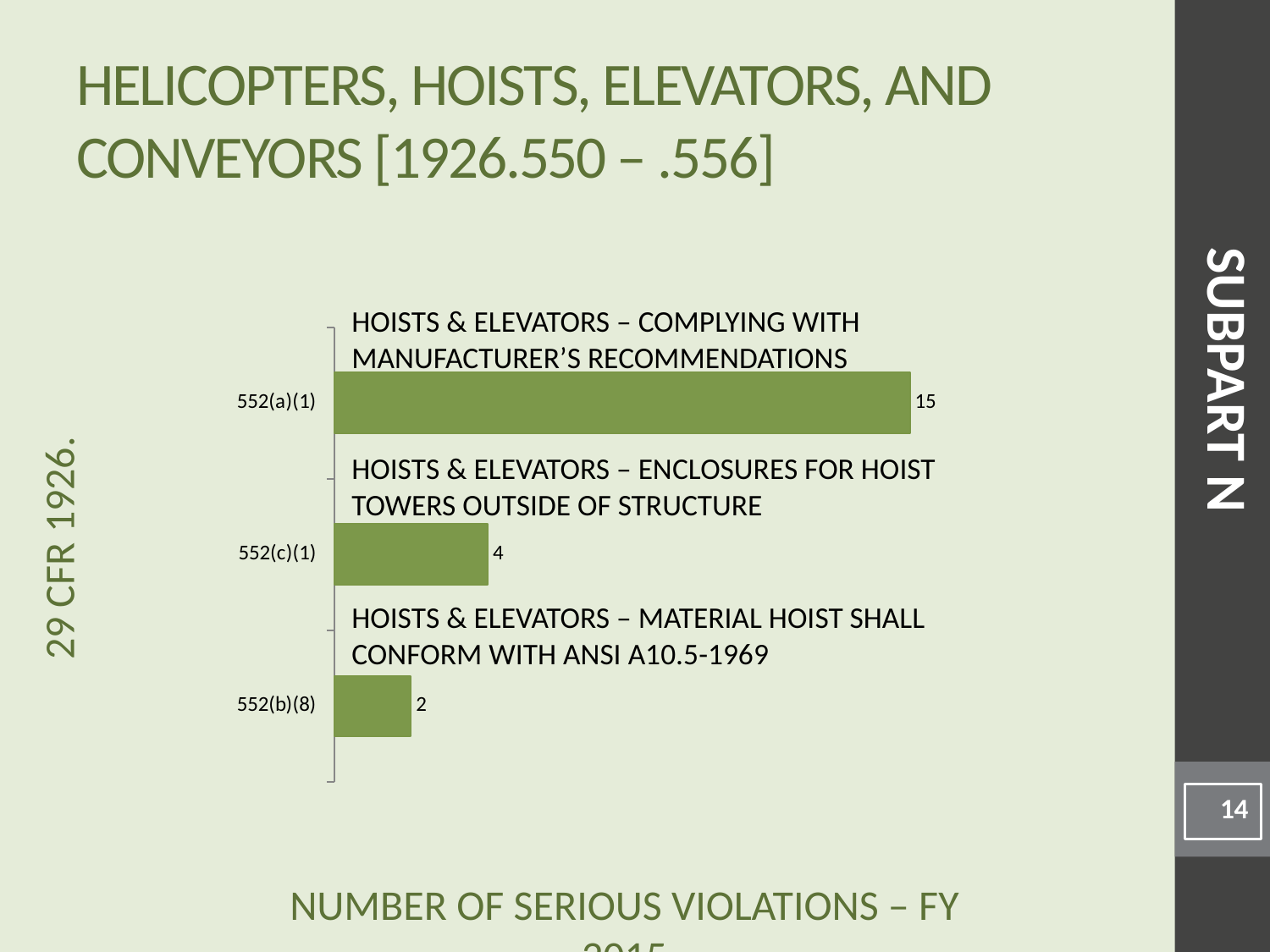
What is the number of serious violations for 552(b)(8)? 2 What is the difference between the violations for 552(a)(1) and 552(c)(1)? 11 What kind of chart is shown on the slide? Bar chart What is the number of serious violations for 552(c)(1)? 4 Which standard has the highest number of serious violations? 552(a)(1) How many standards (categories) are shown in the chart? 3 What is the difference between the violations for 552(c)(1) and 552(b)(8)? 2 Which has more serious violations, 552(c)(1) or 552(b)(8)? 552(c)(1) Which standard has the lowest number of serious violations? 552(b)(8) What is the total number of serious violations across all three standards shown? 21 What is the number of serious violations for 552(a)(1)? 15 Which standard is described as 'HOISTS & ELEVATORS – MATERIAL HOIST SHALL CONFORM WITH ANSI A10.5-1969'? 552(b)(8)